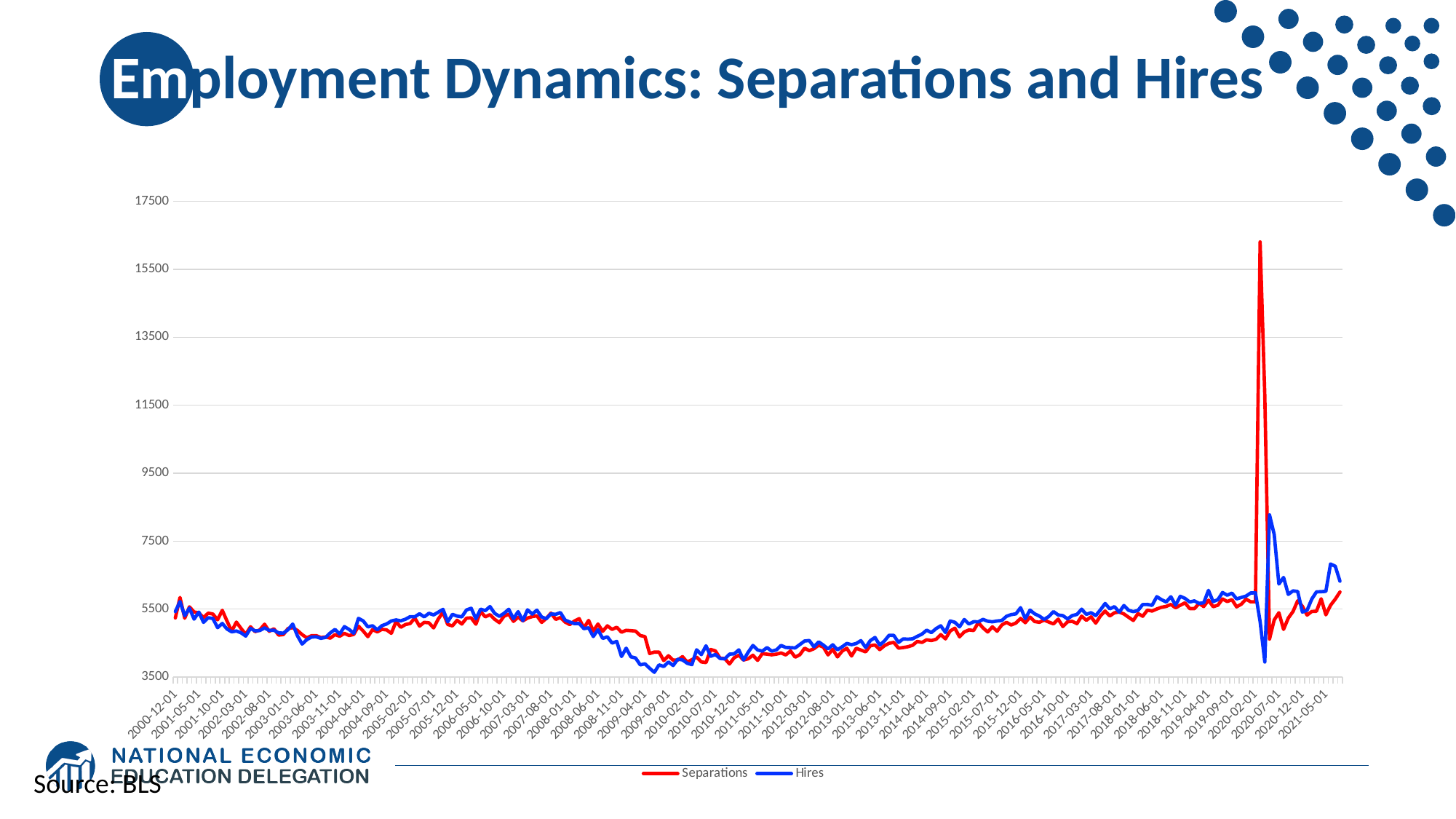
What is the title of the slide's chart? Employment Dynamics: Separations and Hires Do the Hires values generally rise or fall between 2010-07-01 and 2019-09-01? rise Is the peak value of Hires in 2020 greater or less than 7500? greater Which series is drawn in red? Separations Is the value of Hires around 2009-09-01 greater or less than 5500? less What kind of chart is shown on the slide? line chart How many series does the legend list? 2 Is the peak value of Separations in 2020 greater or less than 15500? greater Which series reaches the highest value on the chart? Separations Which series has the higher peak in 2020, Separations or Hires? Separations What is the lowest value shown on the y axis? 3500 Do the Hires values rise or fall between 2008-06-01 and 2009-04-01? fall